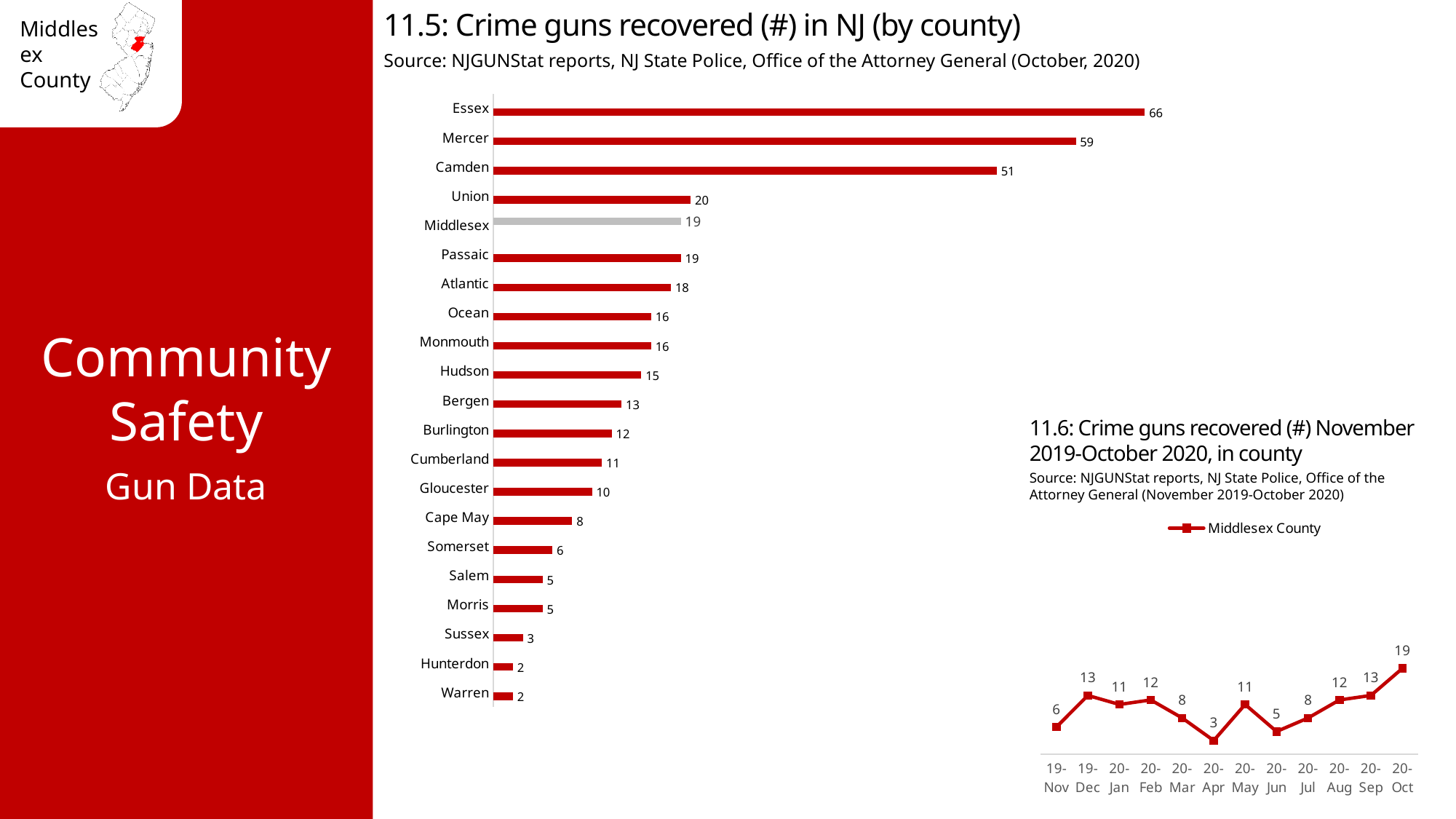
In the chart '11.5: Crime guns recovered (#) in NJ (by county)', what is the difference between Essex and Mercer? 7 In the chart '11.6: Crime guns recovered (#) November 2019-October 2020, in county', which month has the highest value? 20-Oct In the chart '11.6: Crime guns recovered (#) November 2019-October 2020, in county', what is the difference between 20-Oct and 19-Nov? 13 In the chart '11.5: Crime guns recovered (#) in NJ (by county)', which has more crime guns recovered, Union or Hudson? Union In the chart '11.5: Crime guns recovered (#) in NJ (by county)', how many counties are shown? 21 In the chart '11.6: Crime guns recovered (#) November 2019-October 2020, in county', how many series does the legend list? 1 In the chart '11.6: Crime guns recovered (#) November 2019-October 2020, in county', do the values rise or fall from 20-Jun to 20-Oct? Rise In the chart '11.6: Crime guns recovered (#) November 2019-October 2020, in county', what is the value for 20-Apr? 3 What kind of chart is '11.5: Crime guns recovered (#) in NJ (by county)'? Bar chart In the chart '11.5: Crime guns recovered (#) in NJ (by county)', what is the value for Camden? 51 In the chart '11.5: Crime guns recovered (#) in NJ (by county)', how many crime guns were recovered in Middlesex? 19 In the chart '11.5: Crime guns recovered (#) in NJ (by county)', which county has the highest number of crime guns recovered? Essex